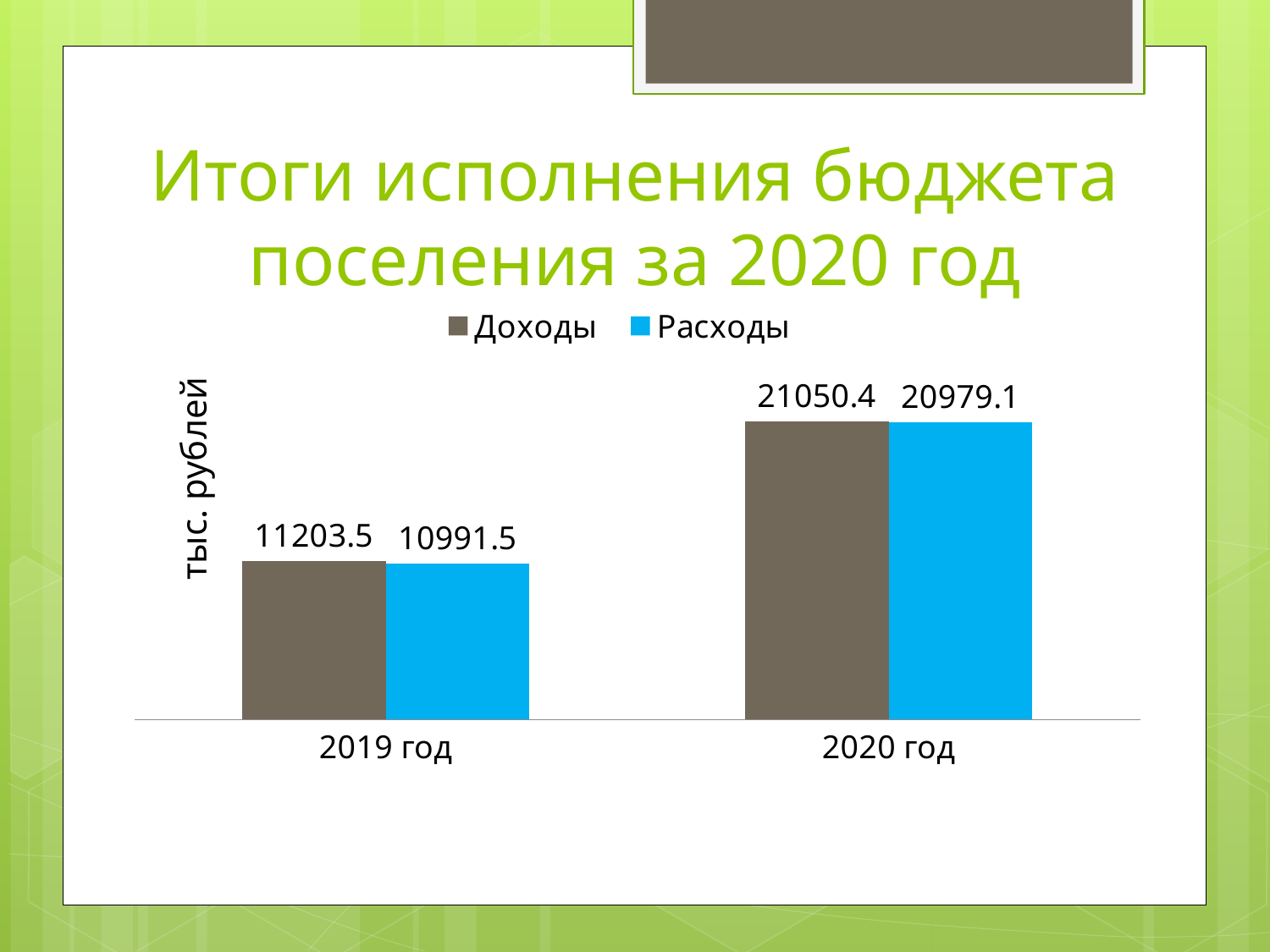
How many series does the legend list? 2 What is the value of Доходы for 2020 год? 21050.4 Which year has the lower value of Расходы? 2019 год What is the difference between Доходы and Расходы for 2019 год? 212.0 Which year has the higher value of Доходы? 2020 год How many categories are shown on the x axis? 2 What is the difference between Доходы and Расходы for 2020 год? 71.3 What is the value of Расходы for 2019 год? 10991.5 What is the label of the vertical axis? тыс. рублей What is the value of Расходы for 2020 год? 20979.1 What kind of chart is shown on the slide? Bar chart What is the value of Доходы for 2019 год? 11203.5